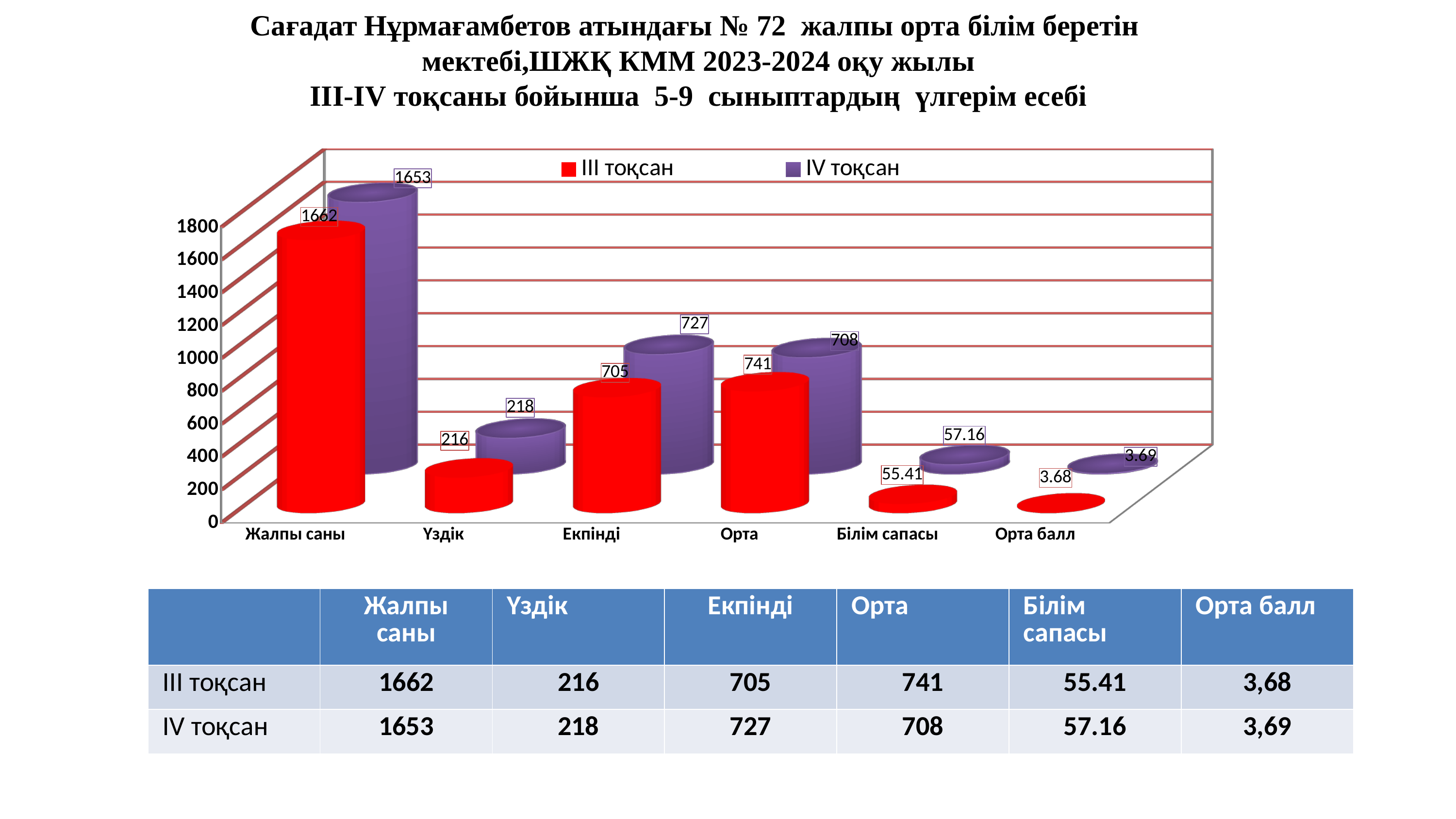
Which category has the highest value in the IV тоқсан series? Жалпы саны Which is larger for Үздік: the III тоқсан value or the IV тоқсан value? IV тоқсан What is the value for Білім сапасы in the IV тоқсан series? 57.16 How many categories are shown on the x axis of the chart? 6 Which category has the lowest value in the III тоқсан series? Орта балл How many series does the chart legend list? 2 What is the difference between the III тоқсан and IV тоқсан values for Орта? 33 What is the value for Орта балл in the III тоқсан series? 3.68 What kind of chart is shown on the slide? bar chart What is the value for Жалпы саны in the III тоқсан series? 1662 What is the difference between the IV тоқсан and III тоқсан values for Екпінді? 22 What is the value for Екпінді in the IV тоқсан series? 727